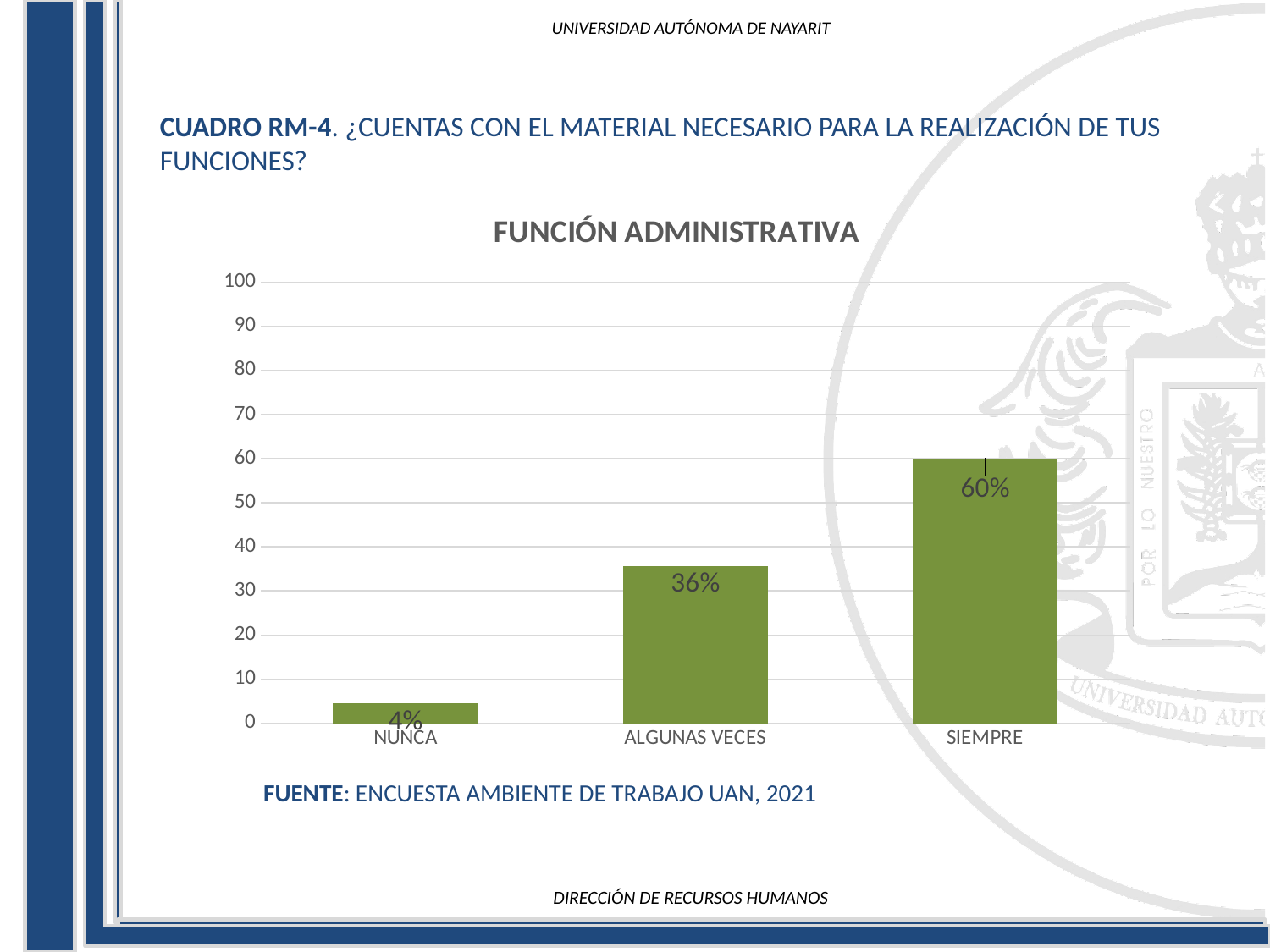
What kind of chart is shown? bar chart What is the value for ALGUNAS VECES? 36% What is the value for SIEMPRE? 60% Which is larger, the value for ALGUNAS VECES or the value for NUNCA? ALGUNAS VECES What is the value for NUNCA? 4% What is the title of the chart? FUNCIÓN ADMINISTRATIVA Which category has the highest value? SIEMPRE How many categories are shown on the x axis? 3 Is the value for SIEMPRE greater or less than 50? greater What is the difference between the values for SIEMPRE and ALGUNAS VECES? 24% What is the difference between the values for ALGUNAS VECES and NUNCA? 32% Which category has the lowest value? NUNCA